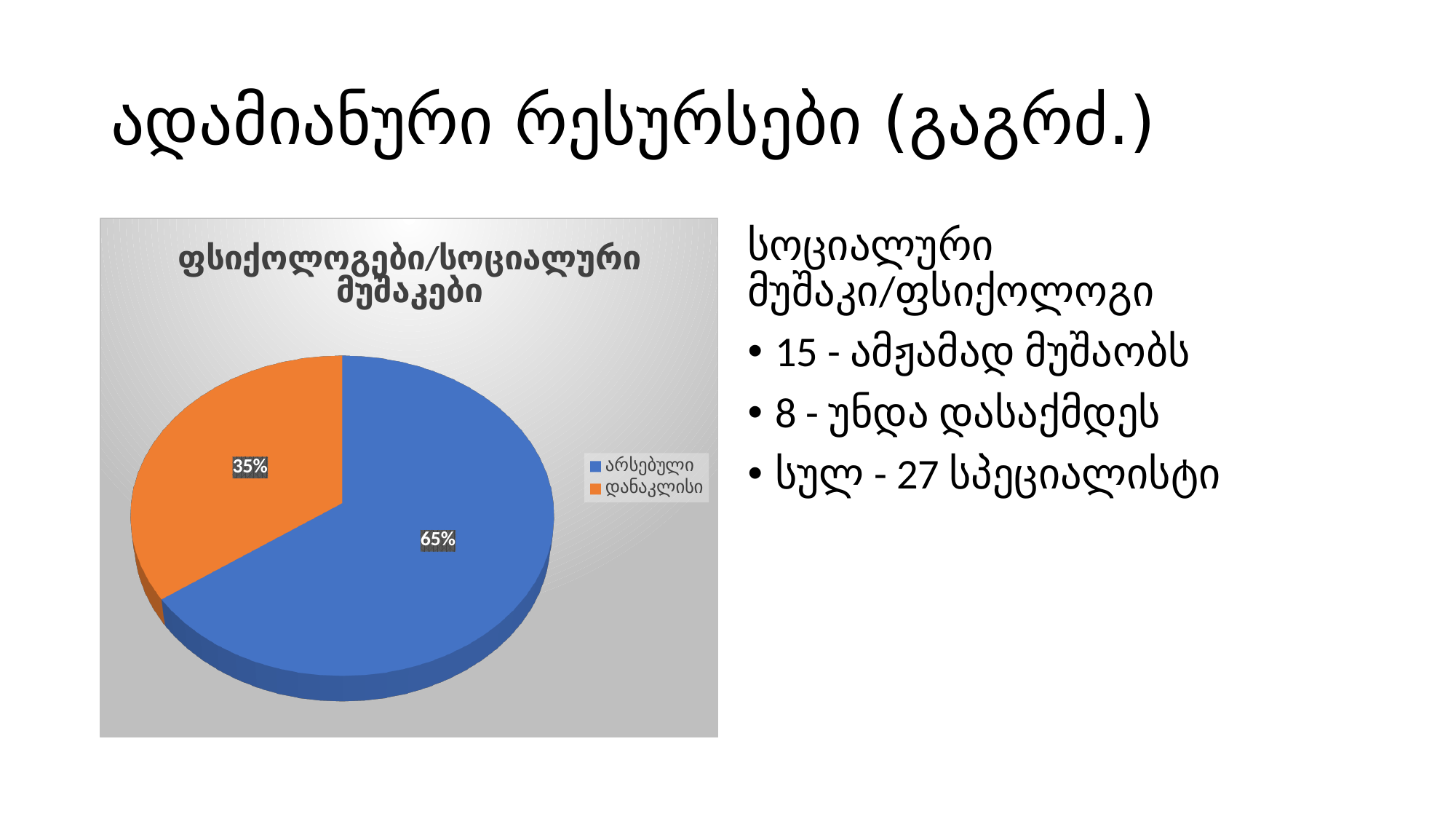
How many slices does the pie chart have? 2 Which slice of the pie is the smallest? დანაკლისი What is the title of the chart? ფსიქოლოგები/სოციალური მუშაკები What share of the pie does the slice labelled არსებული take? 65% Which is larger, the არსებული slice or the დანაკლისი slice? არსებული What colour is the slice labelled დანაკლისი? orange What kind of chart is shown on the slide? pie chart Which slice of the pie is the largest? არსებული What share of the pie does the slice labelled დანაკლისი take? 35% What is the difference in percentage points between the არსებული slice and the დანაკლისი slice? 30 How many entries does the chart legend list? 2